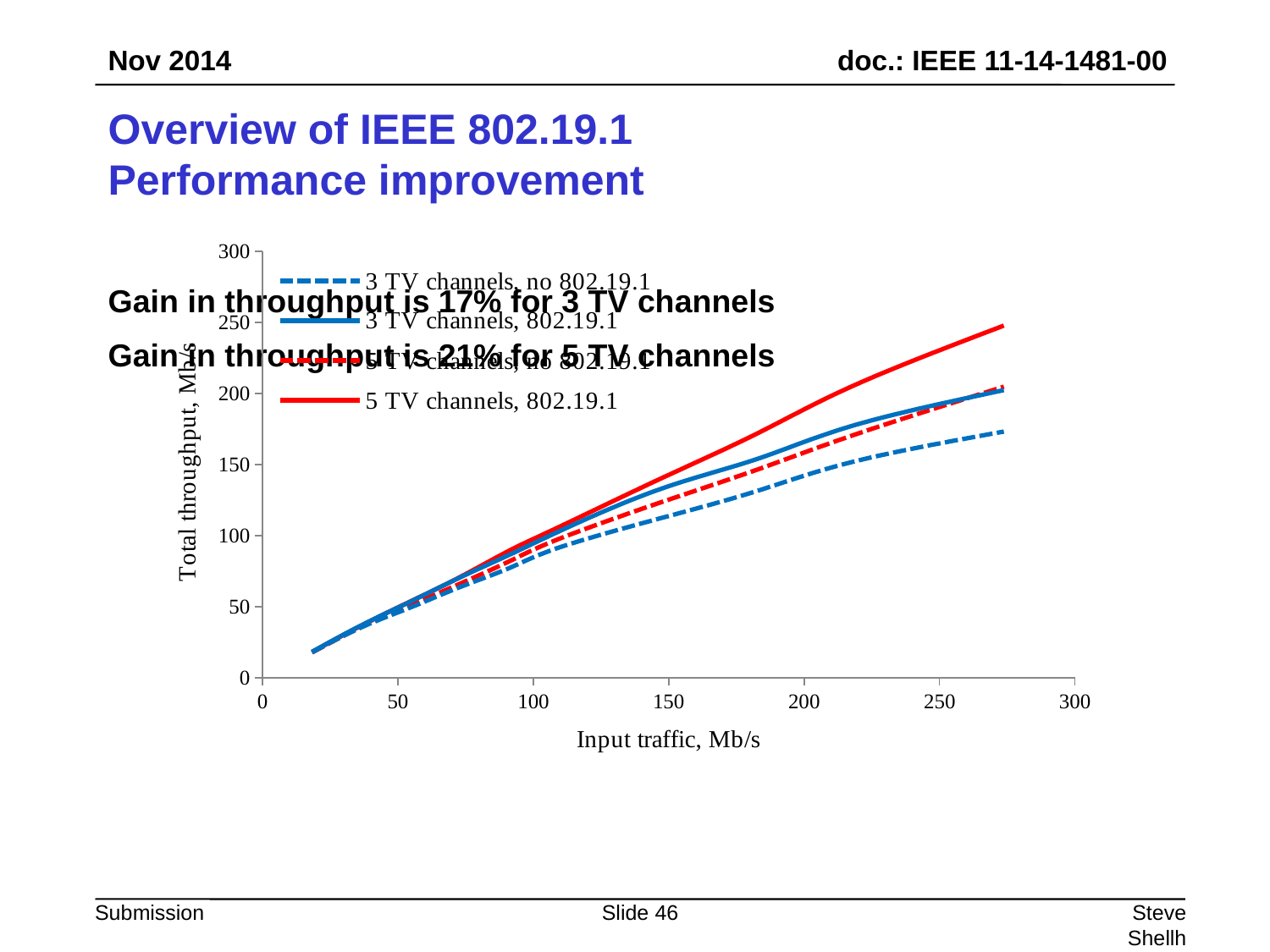
How many series does the chart legend list? 4 Which series has the lowest total throughput at the right end of the chart? 3 TV channels, no 802.19.1 At an input traffic of 250 Mb/s, is the total throughput for 5 TV channels, 802.19.1 greater or less than 200? greater What kind of chart is shown on the slide? line chart Which series reaches the highest total throughput at the right end of the chart? 5 TV channels, 802.19.1 Does total throughput rise or fall as input traffic increases along the x axis? rise What is the label of the vertical axis of the chart? Total throughput, Mb/s At an input traffic of 250 Mb/s, which series has the higher total throughput: 5 TV channels, 802.19.1 or 3 TV channels, 802.19.1? 5 TV channels, 802.19.1 At an input traffic of 200 Mb/s, is the total throughput for 3 TV channels, no 802.19.1 greater or less than 150? less At an input traffic of 200 Mb/s, is the total throughput for 3 TV channels, 802.19.1 greater or less than 150? greater What is the label of the horizontal axis of the chart? Input traffic, Mb/s